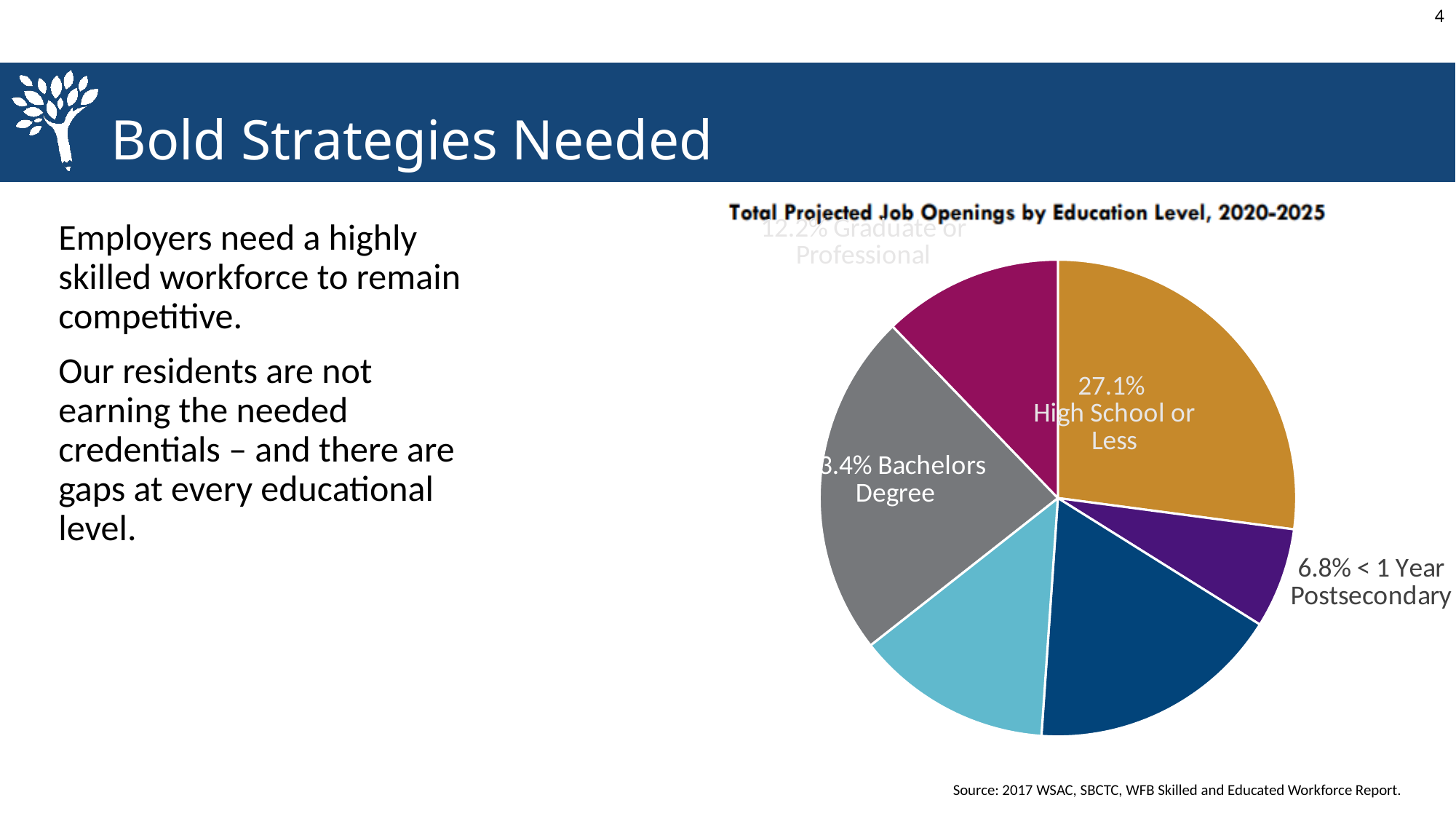
What share of projected job openings is for High School or Less? 27.1% Which education level has the largest slice of the pie? High School or Less What is the difference in percentage points between the High School or Less share and the < 1 Year Postsecondary share? 20.3 percentage points What is the title of the chart? Total Projected Job Openings by Education Level, 2020-2025 What share of projected job openings is for < 1 Year Postsecondary? 6.8% What kind of chart is shown on the slide? Pie chart What share of projected job openings is for Graduate or Professional? 12.2% Is the share for < 1 Year Postsecondary greater or less than 10%? less Which education level has the smallest slice of the pie? < 1 Year Postsecondary Which is larger: the share for High School or Less or the share for < 1 Year Postsecondary? High School or Less What colour is the High School or Less slice? Gold How many slices does the pie chart have? 6